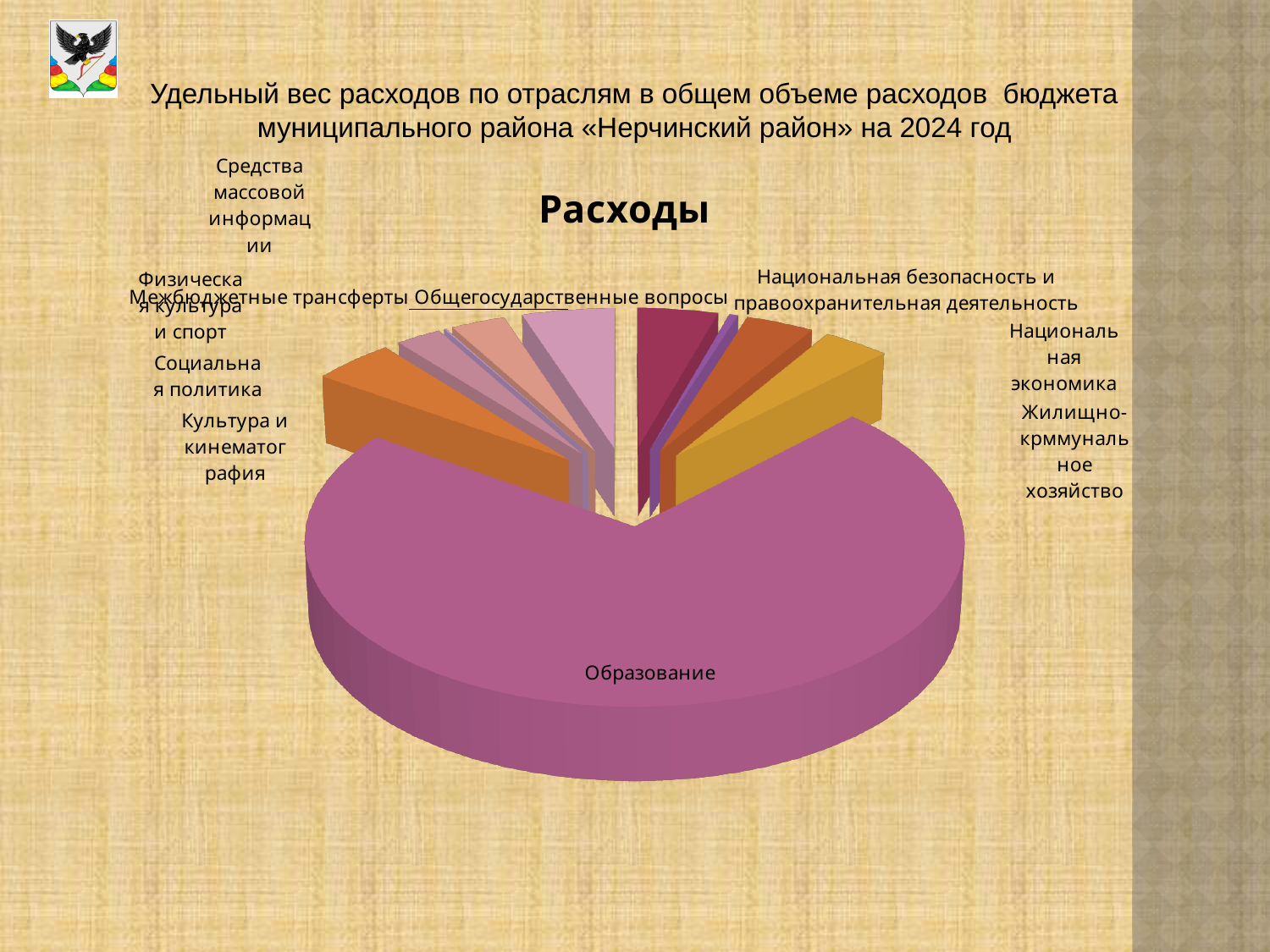
Which slice is larger: Образование or Общегосударственные вопросы? Образование What kind of chart is shown on the slide? pie chart Which year does the slide title say the budget expenditure shares refer to? 2024 What is the title of the pie chart? Расходы Which category has the largest slice in the pie chart? Образование Which slice is larger: Образование or Жилищно-коммунальное хозяйство? Образование How many categories are shown in the pie chart? 10